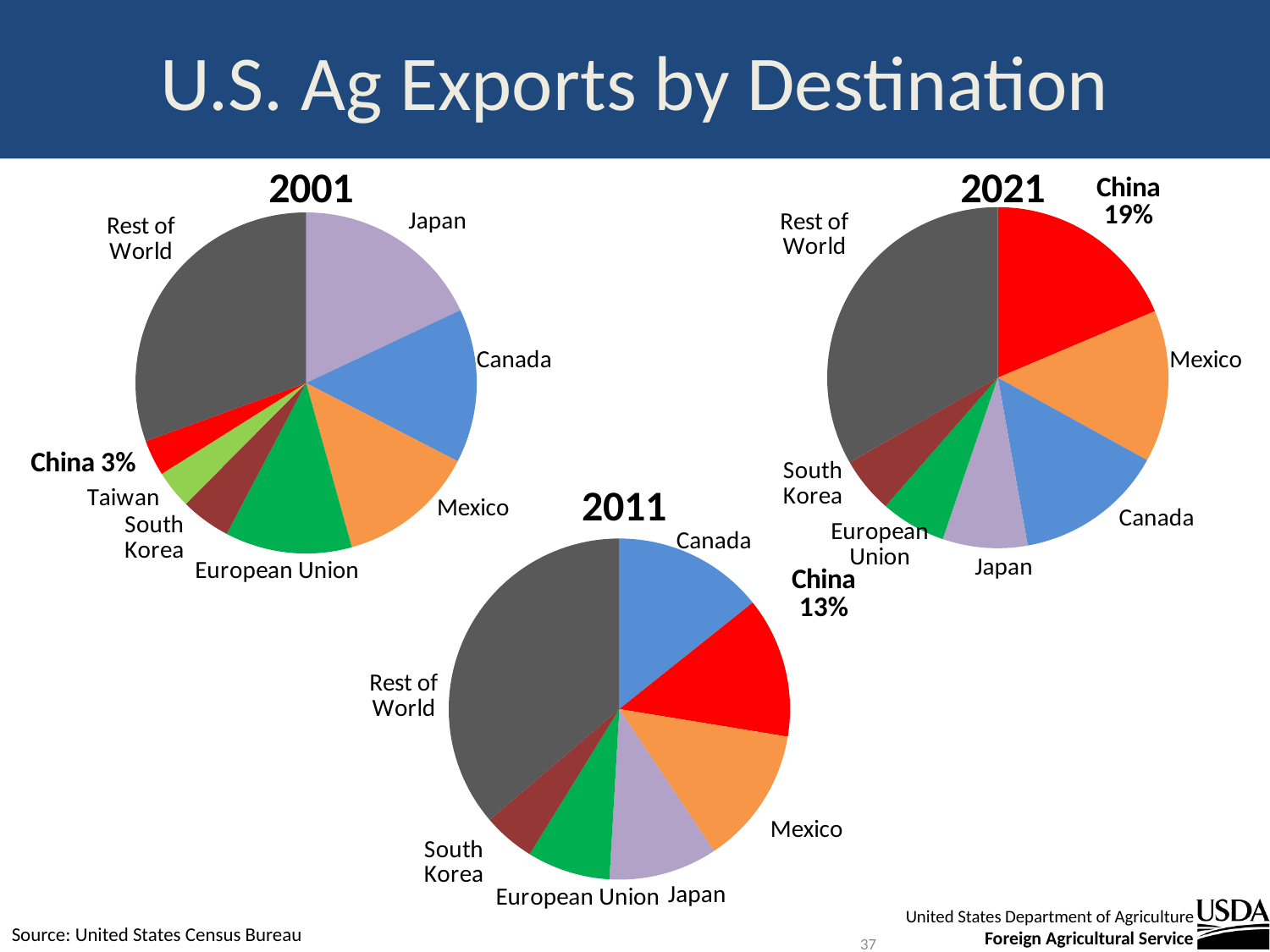
How many slices does the 2001 pie chart have? 8 By how many percentage points did China's share of U.S. ag exports grow between the 2001 chart and the 2021 chart? 16 percentage points In the 2021 pie chart, what share of U.S. ag exports went to China? 19% What kind of chart is used on this slide to show U.S. ag exports by destination? Pie chart In the 2001 pie chart, what share of U.S. ag exports went to China? 3% Across the 2001, 2011 and 2021 charts, does China's share of U.S. ag exports rise or fall over time? rise In the 2011 pie chart, which slice is larger, Mexico or Japan? Mexico By how many percentage points did China's share of U.S. ag exports grow between the 2001 chart and the 2011 chart? 10 percentage points In the 2021 pie chart, which destination has the largest slice? Rest of World In the 2021 pie chart, which slice is larger, China or Mexico? China In the 2001 pie chart, which destination has the largest slice? Rest of World In the 2011 pie chart, what share of U.S. ag exports went to China? 13%